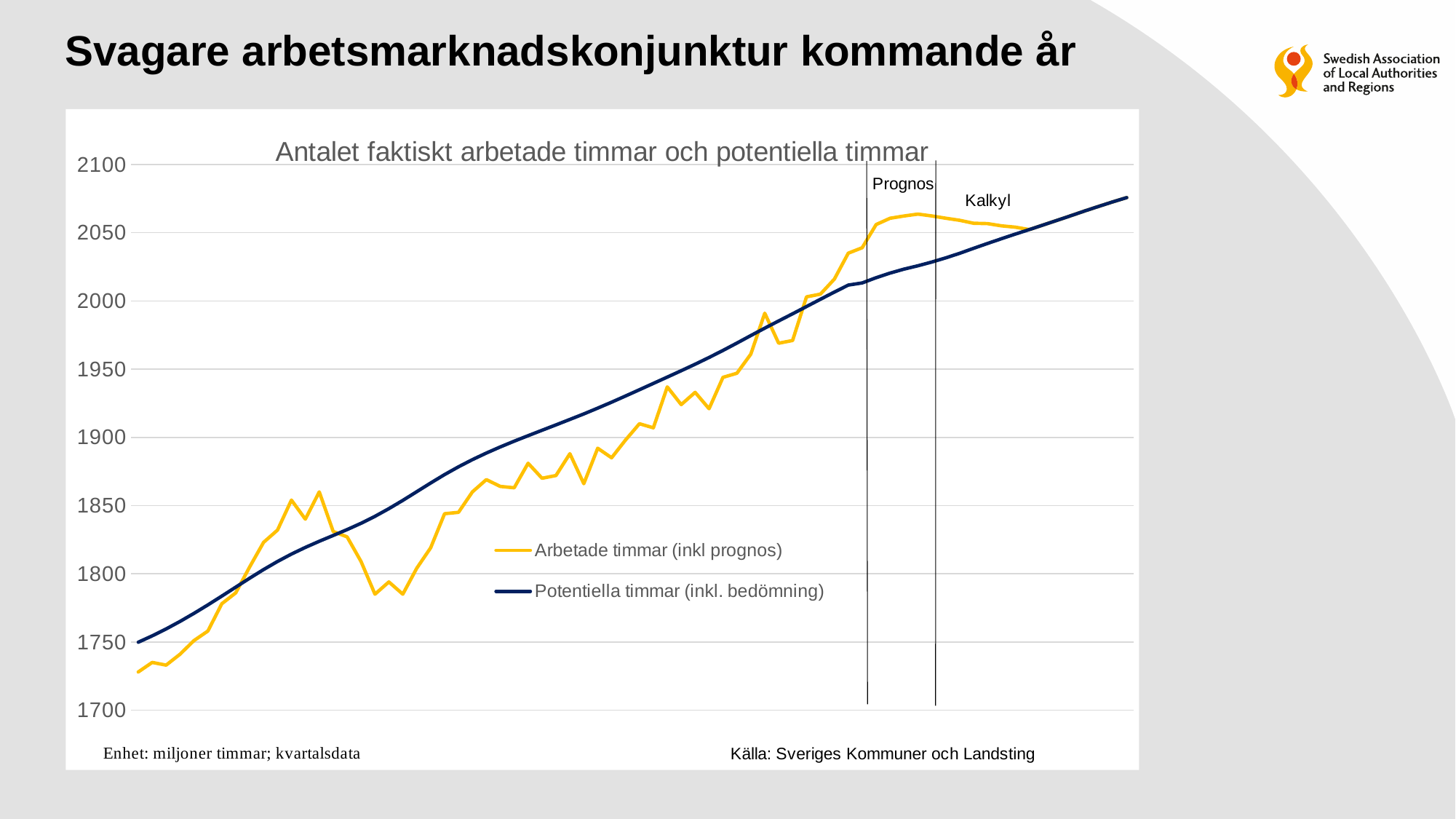
Is the starting value of the Arbetade timmar (inkl prognos) series greater or less than 1750? less What is the highest value shown on the y axis? 2100 Which series is drawn in dark blue according to the legend? Potentiella timmar (inkl. bedömning) Is the final value of the Potentiella timmar (inkl. bedömning) series greater or less than 2050? greater Does the Potentiella timmar (inkl. bedömning) series rise or fall along the x axis overall? Rises Is the lowest value of the Potentiella timmar (inkl. bedömning) series greater or less than 1700? greater How many series does the legend list? 2 What kind of chart is shown on the slide? Line chart At the left end of the chart, which series has the higher value: Arbetade timmar (inkl prognos) or Potentiella timmar (inkl. bedömning)? Potentiella timmar (inkl. bedömning) What is the title of the chart? Antalet faktiskt arbetade timmar och potentiella timmar